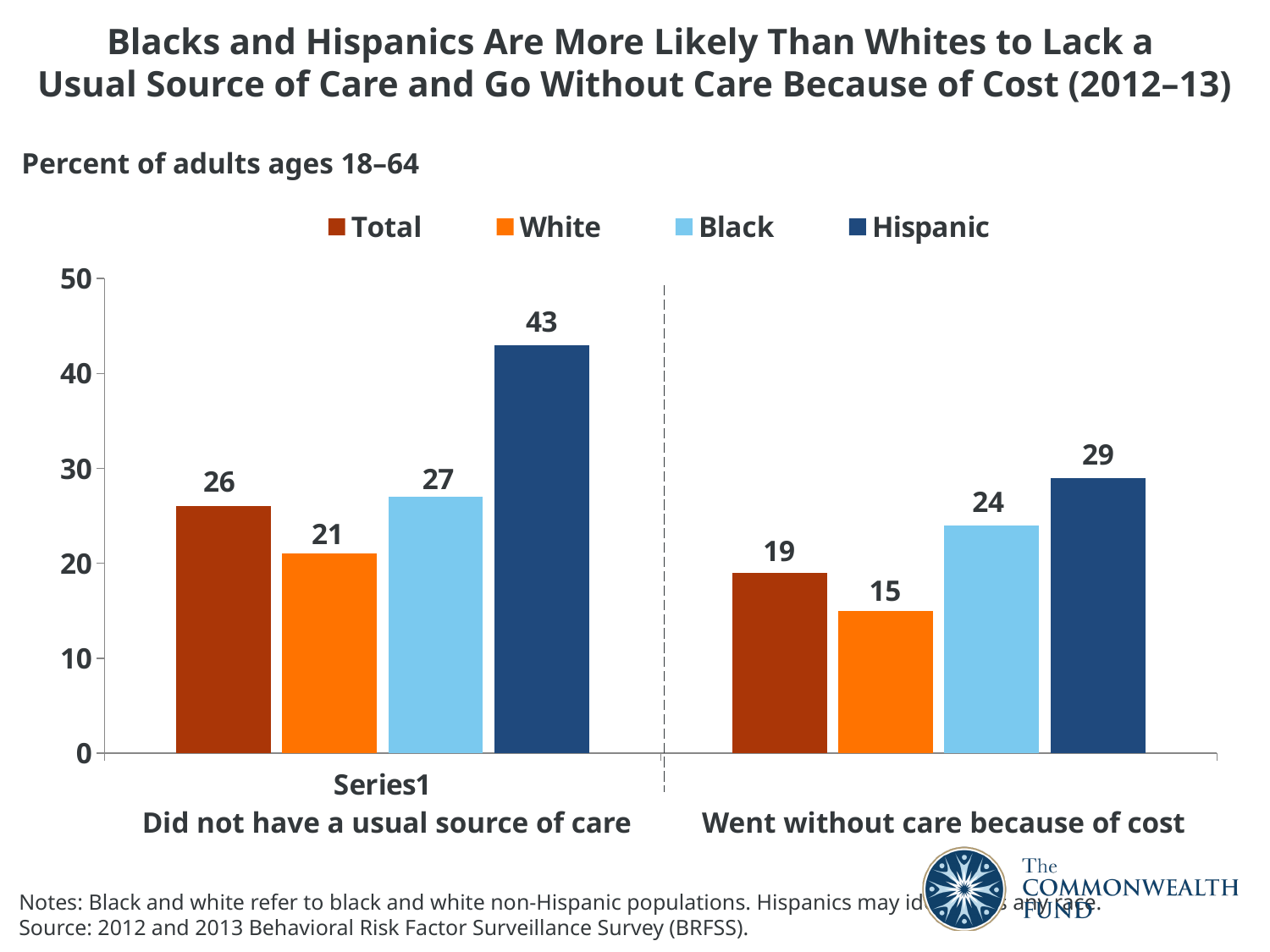
What colour are the Hispanic bars? Dark blue What is the value for White in the 'Went without care because of cost' group? 15 How many series does the legend list? 4 What is the difference between the Black and White values in the 'Went without care because of cost' group? 9 Which series has the lowest value in the 'Went without care because of cost' group? White What is the value for Hispanic in the 'Did not have a usual source of care' group? 43 What is the value for Total in the 'Went without care because of cost' group? 19 Which is larger: the Total value for 'Did not have a usual source of care' or the Total value for 'Went without care because of cost'? Did not have a usual source of care What is the difference between the Hispanic and White values in the 'Did not have a usual source of care' group? 22 What kind of chart is shown on the slide? Bar chart Which series has the highest value in the 'Did not have a usual source of care' group? Hispanic What is the value for Black in the 'Did not have a usual source of care' group? 27